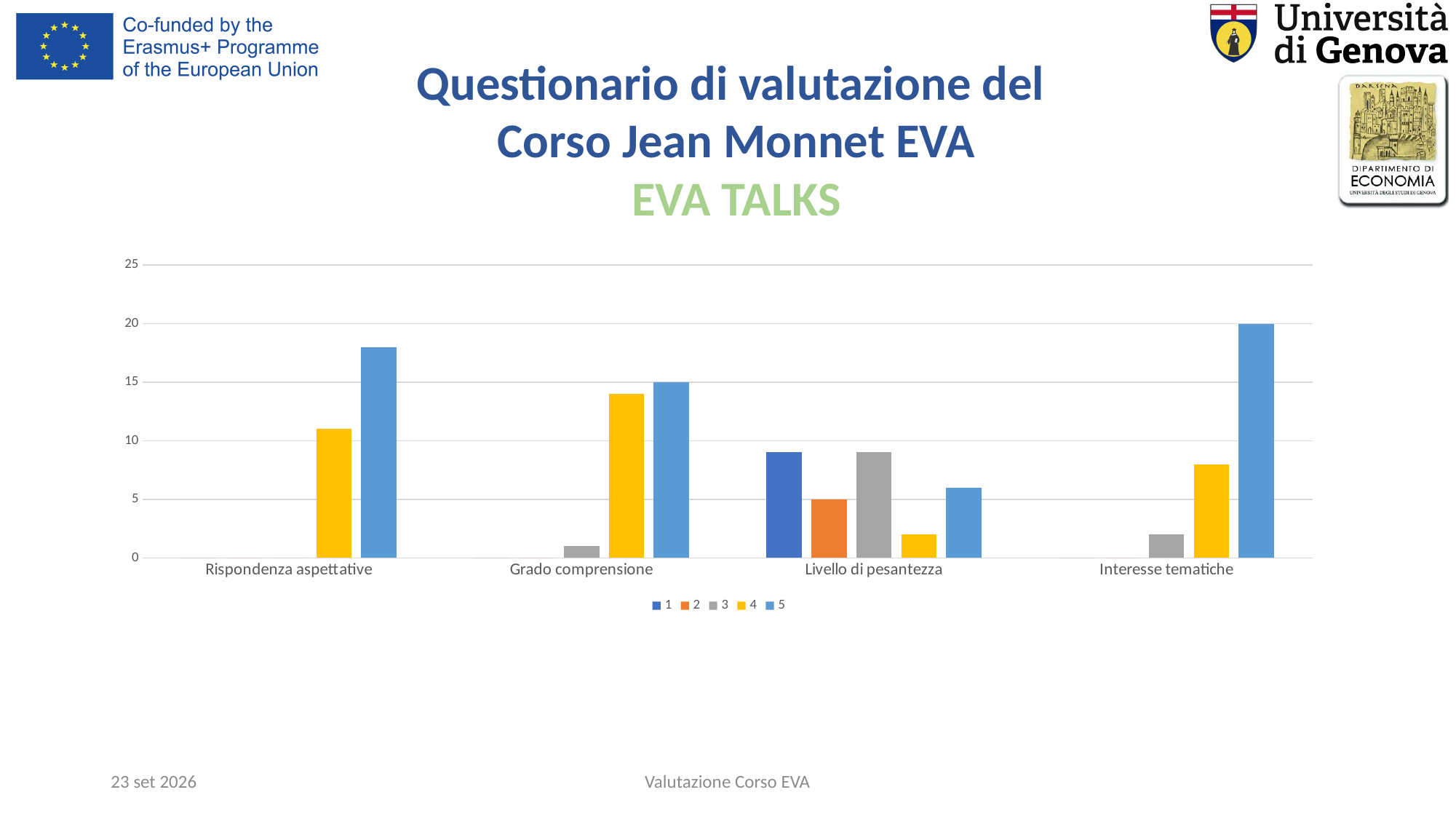
What are the entries listed in the chart's legend? 1, 2, 3, 4, 5 Is the value of series 5 for Rispondenza aspettative greater or less than 15? greater Within Livello di pesantezza, which series has the lowest value? 4 How many series does the chart's legend list? 5 What kind of chart is shown on the slide? bar chart How many categories are shown on the x axis of the chart? 4 What is the value of series 5 for Interesse tematiche? 20 Is the value of series 1 for Livello di pesantezza greater or less than 10? less Which is larger: series 5 for Rispondenza aspettative or series 5 for Grado comprensione? Rispondenza aspettative What is the value of series 5 for Grado comprensione? 15 Which category has the tallest bar in the chart? Interesse tematiche What is the value of series 2 for Livello di pesantezza? 5